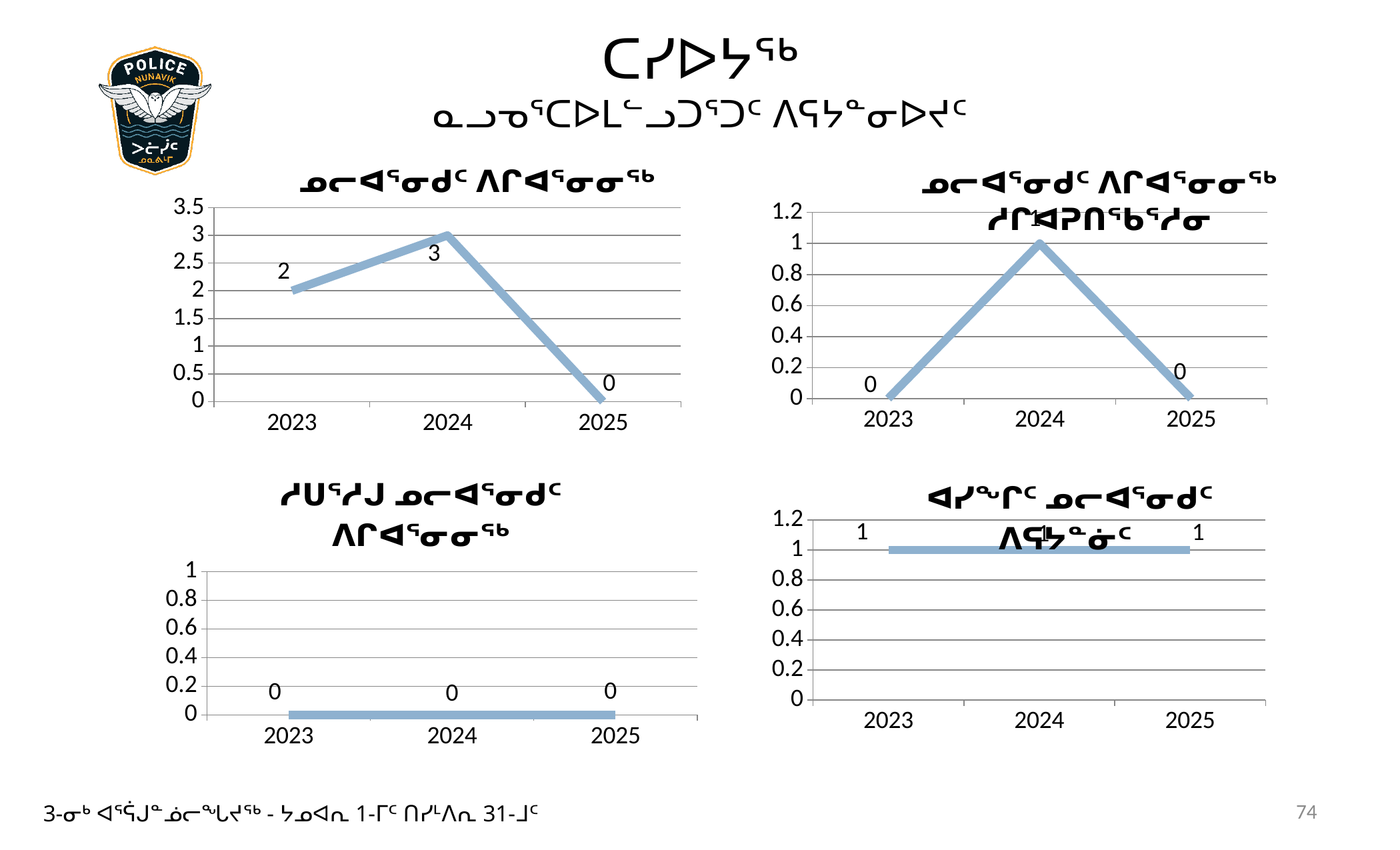
In the top-left chart, which year has the lowest value? 2025 How many charts are shown on the slide? 4 In the top-right chart, what is the value for 2025? 0 In the bottom-left chart, what is the value for 2024? 0 In the bottom-right chart, what is the value for 2023? 1 In the top-left chart, is the value for 2024 greater or less than 2.5? greater In the top-right chart, which year has the highest value? 2024 In the top-left chart, what is the value for 2023? 2 In the top-left chart, what is the value for 2024? 3 In the top-left chart, which year has the highest value? 2024 In the top-left chart, what is the difference between the values for 2024 and 2023? 1 In the top-right chart, what is the value for 2024? 1